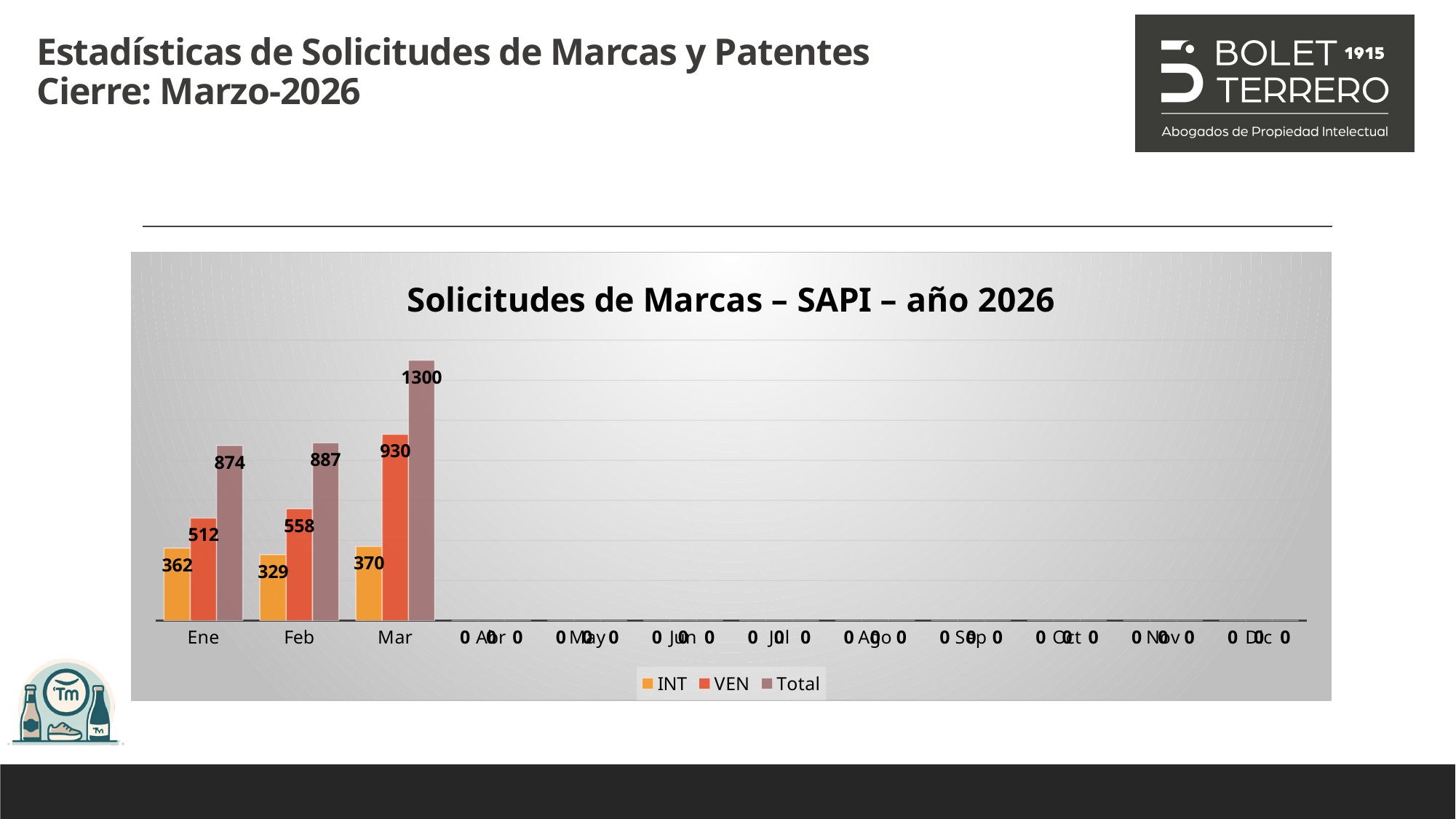
What type of chart is shown on the slide? bar chart What is the difference between the VEN value for Mar and the VEN value for Ene? 418 How many months are shown on the x axis? 12 What is the INT value for Ene? 362 What is the VEN value for Feb? 558 How many series does the legend list? 3 Which is larger, the Total value for Feb or the Total value for Ene? Feb Which month has the highest Total value? Mar What is the title of the chart? Solicitudes de Marcas – SAPI – año 2026 Which of the first three months has the lowest INT value? Feb Does the Total value rise or fall from Ene to Mar? rise What is the Total value for Mar? 1300